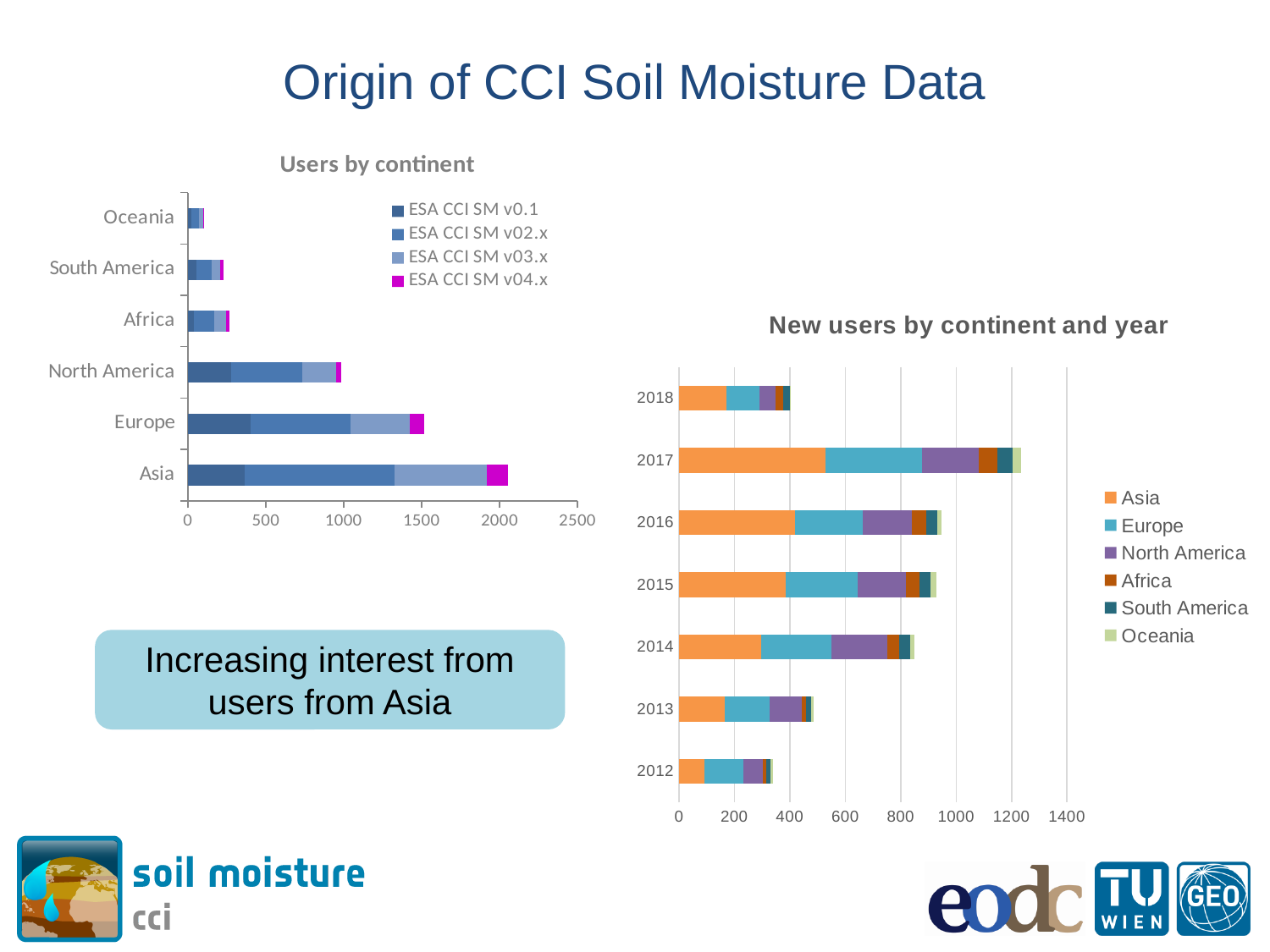
On the 'New users by continent and year' chart, which year has the lowest total number of new users? 2012 On the 'Users by continent' chart, is the total value for North America greater or less than 500? greater On the 'New users by continent and year' chart, is the total value for 2015 greater or less than 800? greater On the 'Users by continent' chart, which continent has the highest total number of users? Asia On the 'Users by continent' chart, is the total value for Asia greater or less than 2000? greater On the 'Users by continent' chart, how many continents are shown? 6 On the 'New users by continent and year' chart, which year has the highest total number of new users? 2017 On the 'Users by continent' chart, which continent has the lowest total number of users? Oceania On the 'Users by continent' chart, how many series does the legend list? 4 What kind of chart is 'New users by continent and year'? Stacked bar chart On the 'New users by continent and year' chart, how many series does the legend list? 6